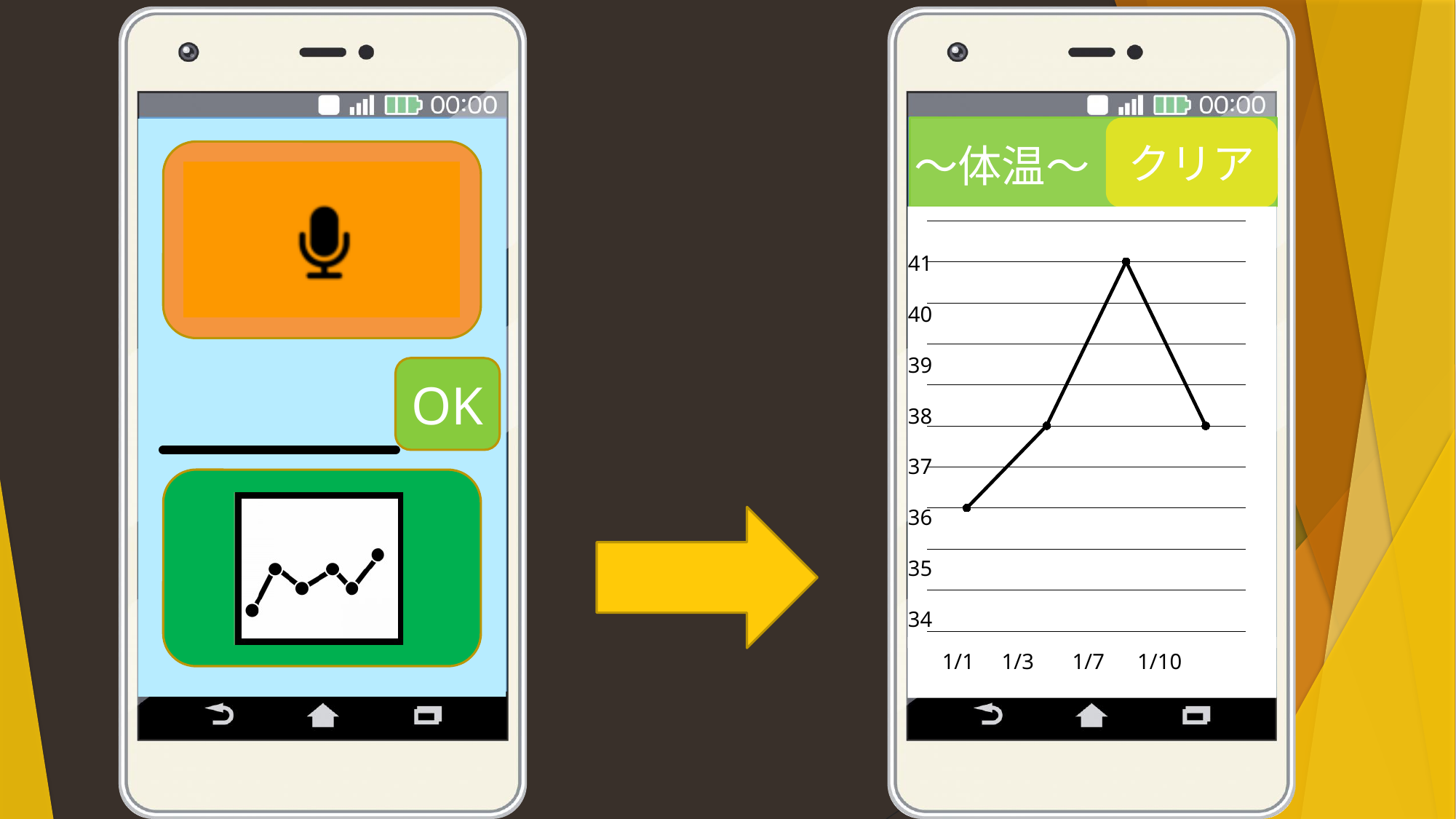
On the chart on the right-hand phone screen, what is the difference between the values for 1/7 and 1/1? 5 On the chart on the right-hand phone screen, which date has the lowest value? 1/1 On the chart on the right-hand phone screen, which is larger, the value for 1/3 or the value for 1/1? 1/3 On the chart on the right-hand phone screen, what is the value for 1/7? 41 What kind of chart is shown on the right-hand phone screen? line chart On the chart on the right-hand phone screen, is the value for 1/7 greater or less than 40? greater On the chart on the right-hand phone screen, what is the value for 1/3? 38 On the chart on the right-hand phone screen, what is the value for 1/1? 36 What is the title shown above the chart on the right-hand phone screen? 〜体温〜 On the chart on the right-hand phone screen, which date has the highest value? 1/7 How many data points are plotted on the chart on the right-hand phone screen? 4 On the chart on the right-hand phone screen, do the values rise or fall from 1/7 to 1/10? fall